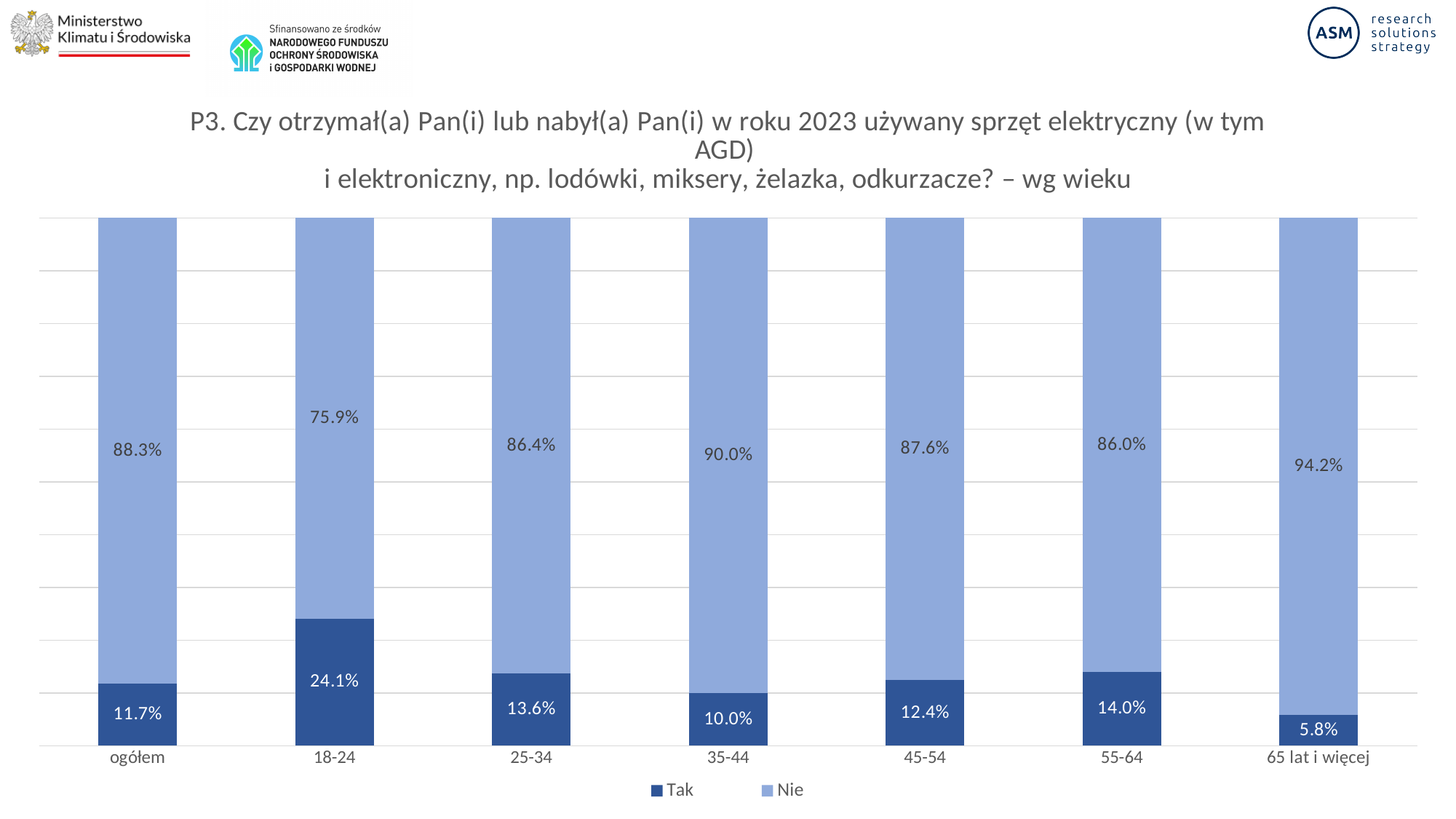
Which age group has the highest 'Tak' value? 18-24 What is the total of the stacked bar for 35-44? 100.0% What is the difference between the 'Tak' values for 18-24 and 65 lat i więcej? 18.3% What is the 'Tak' value for the 18-24 age group? 24.1% What is the 'Nie' value for the 65 lat i więcej group? 94.2% What kind of chart is shown on the slide? stacked bar chart What is the 'Tak' value for ogółem? 11.7% How many series does the legend list? 2 Which age group has the lowest 'Tak' value? 65 lat i więcej What are the two legend entries? Tak, Nie Which is larger, the 'Tak' value for 55-64 or for 45-54? 55-64 How many age categories are shown on the x axis? 7